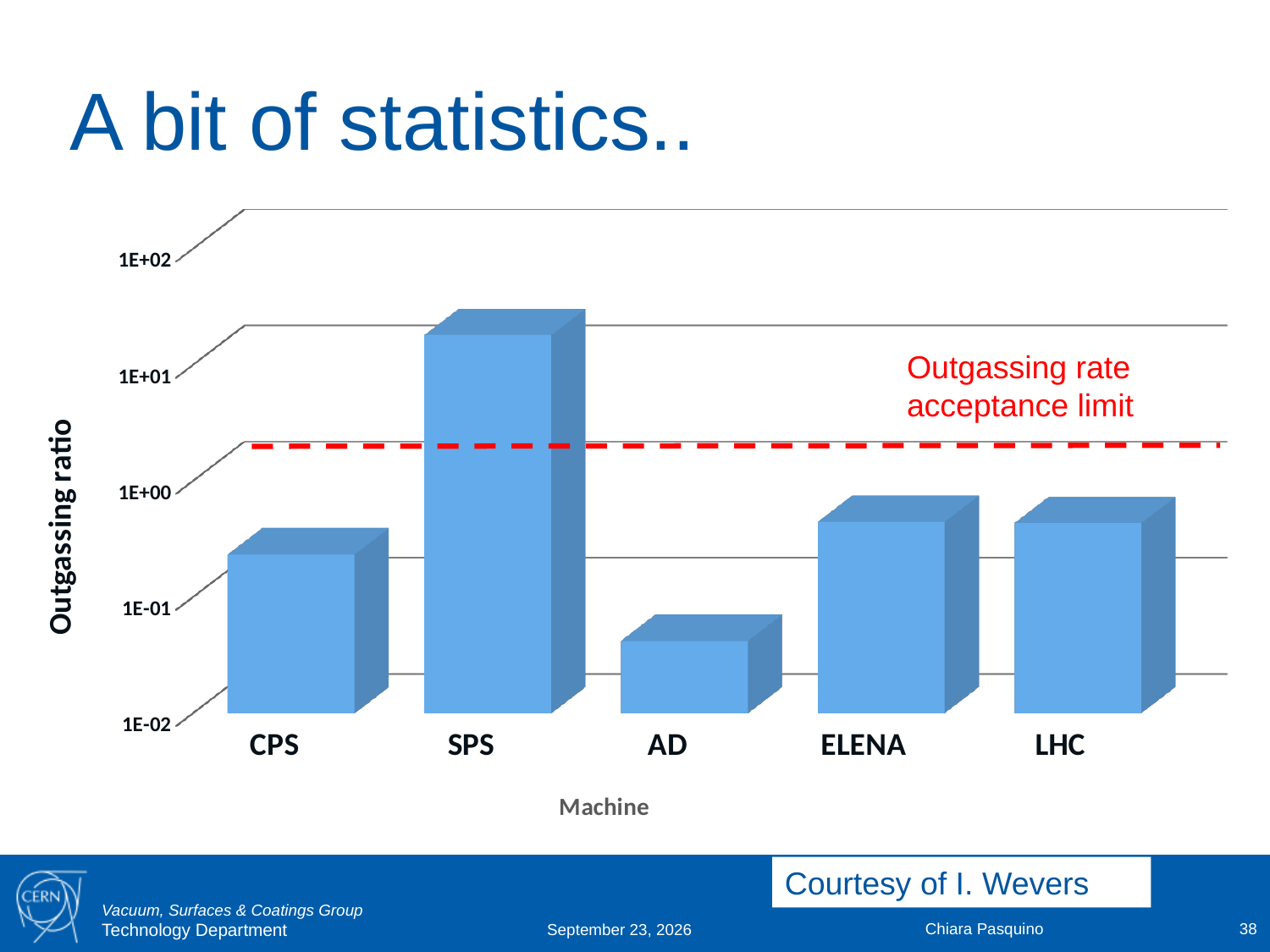
What kind of chart is shown on the slide? bar chart What is the title of the vertical axis of the chart? Outgassing ratio Which machine has the lowest outgassing ratio? AD Which machine has the highest outgassing ratio? SPS Is the outgassing ratio for CPS greater or less than 1E-01? greater Is the outgassing ratio for SPS greater or less than 1E+01? greater Which has a larger outgassing ratio, CPS or AD? CPS How many machines are shown on the x axis of the chart? 5 Which has a larger outgassing ratio, SPS or LHC? SPS Is the outgassing ratio for AD greater or less than 1E-01? less What does the red dashed line on the chart represent? Outgassing rate acceptance limit